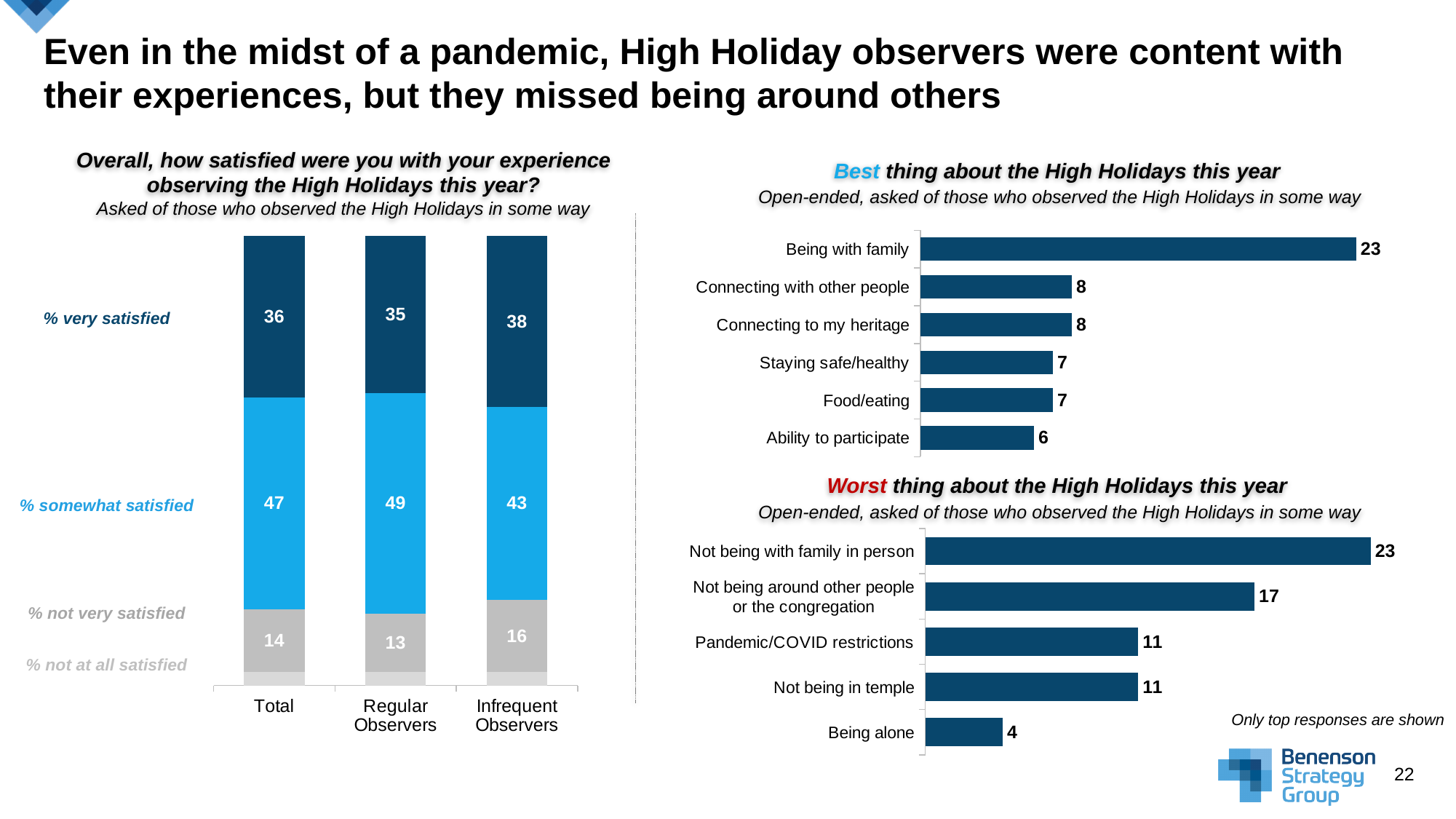
What kind of chart is the 'Worst thing about the High Holidays this year' chart? Bar chart In the satisfaction chart on the left, what is the '% somewhat satisfied' value for Regular Observers? 49 In the 'Worst thing about the High Holidays this year' chart, what is the value for 'Not being around other people or the congregation'? 17 In the satisfaction chart on the left, what is the difference between the '% somewhat satisfied' values for Regular Observers and Infrequent Observers? 6 In the 'Best thing about the High Holidays this year' chart, what is the difference between 'Being with family' and 'Connecting with other people'? 15 In the 'Best thing about the High Holidays this year' chart, what is the value for 'Being with family'? 23 In the 'Worst thing about the High Holidays this year' chart, which category has the highest value? Not being with family in person How many categories are shown in the 'Best thing about the High Holidays this year' chart? 6 In the satisfaction chart on the left, what is the '% very satisfied' value for Infrequent Observers? 38 How many categories are shown in the 'Worst thing about the High Holidays this year' chart? 5 In the 'Best thing about the High Holidays this year' chart, which category has the lowest value? Ability to participate In the 'Worst thing about the High Holidays this year' chart, which is larger: 'Pandemic/COVID restrictions' or 'Being alone'? Pandemic/COVID restrictions